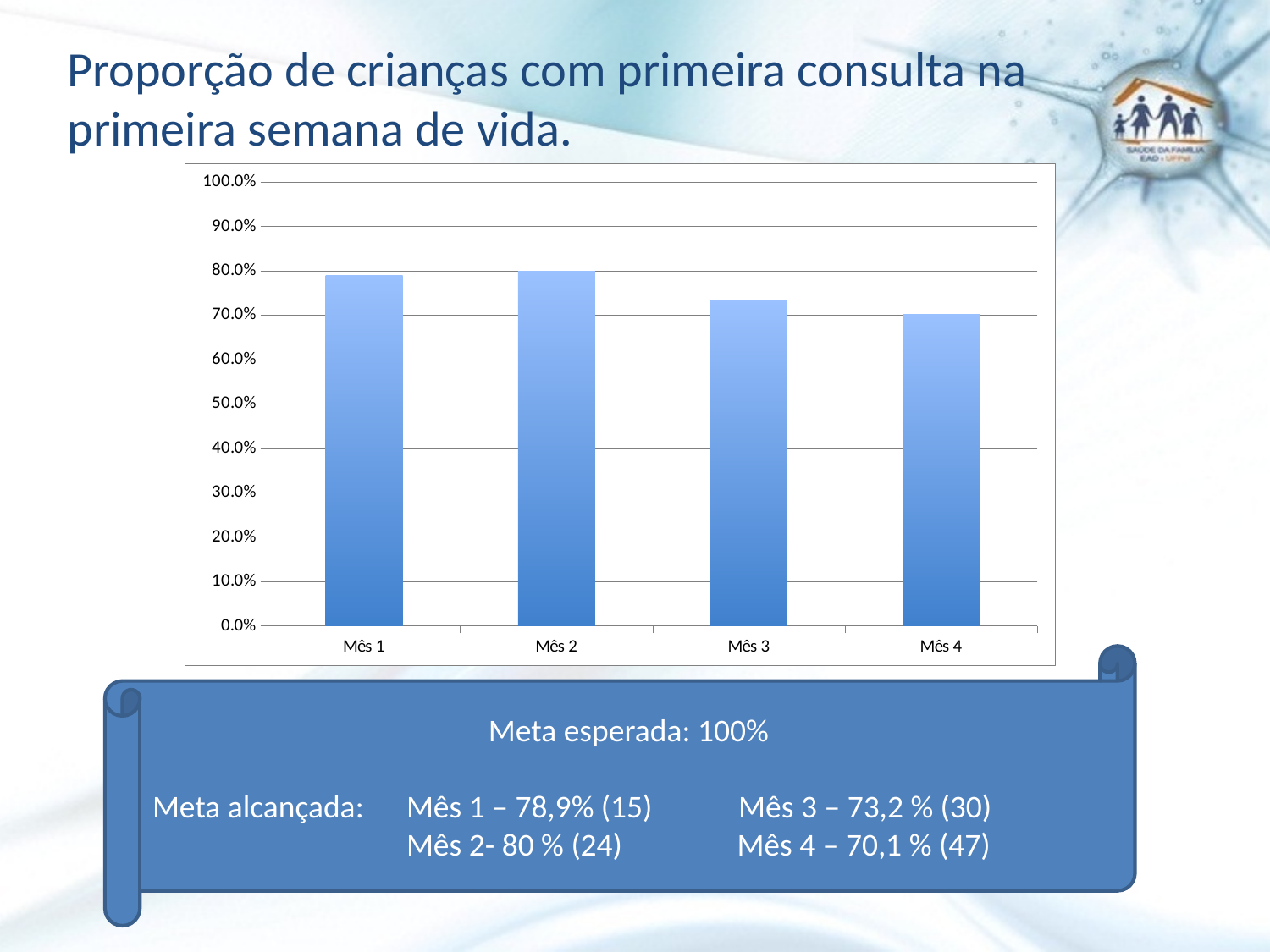
What is the difference between the values for Mês 2 and Mês 4, using the figures printed on the slide? 9,9% According to the slide, what proportion was reached in Mês 1? 78,9% Which month has the lowest bar on the chart? Mês 4 According to the slide, what proportion was reached in Mês 3? 73,2 % Is the value for Mês 1 greater or less than 70.0%? greater How many months (categories) are plotted on the chart? 4 What is the expected target (meta esperada) stated on the slide? 100% Is the value for Mês 3 greater or less than 80.0%? less What kind of chart is shown on the slide? bar chart According to the slide, what proportion was reached in Mês 4? 70,1 % Which is larger, the value for Mês 3 or the value for Mês 4? Mês 3 From Mês 2 to Mês 4, do the values rise or fall? fall